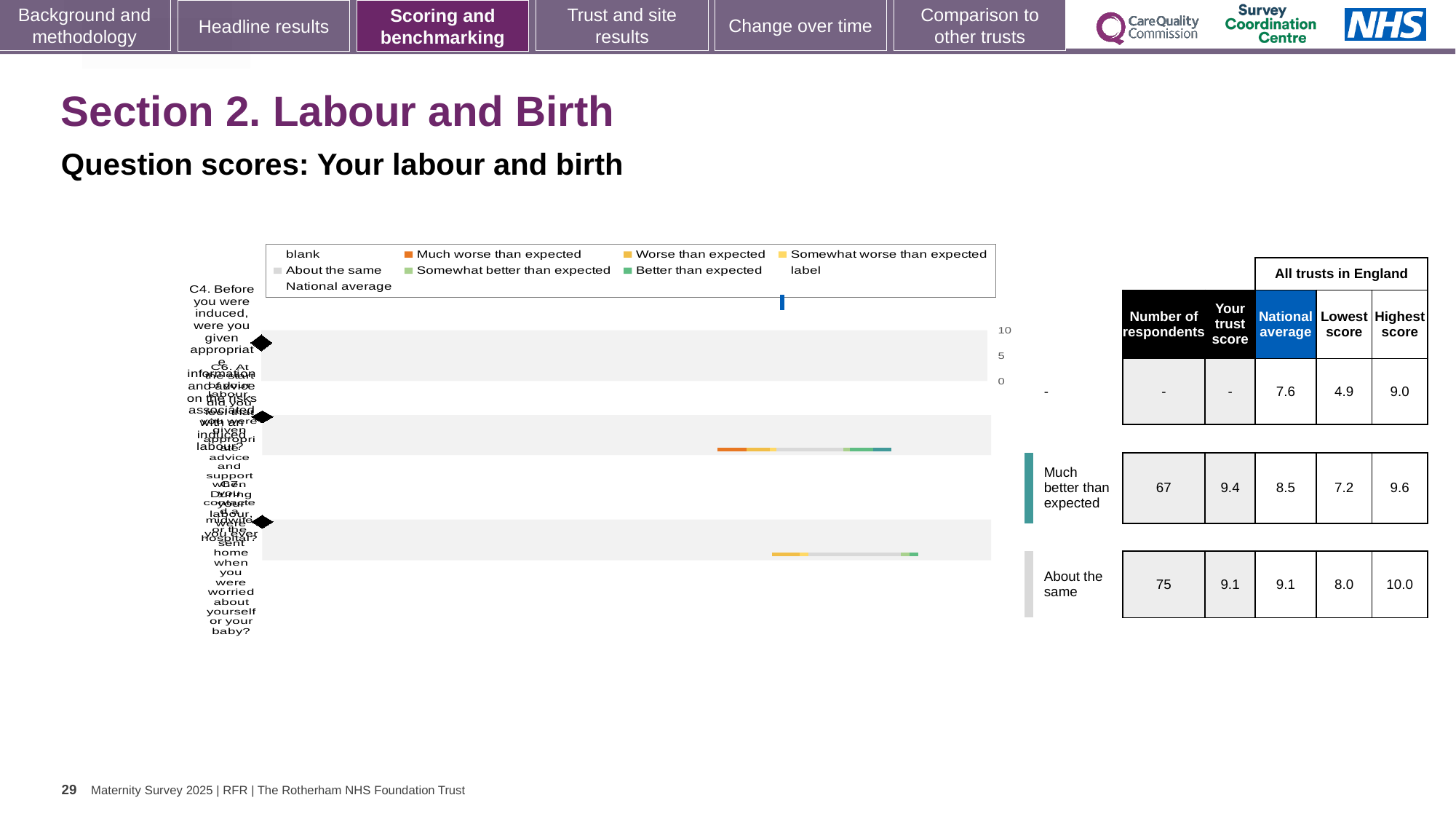
In the table beside the chart, what is the lowest score in the first row (the row with no trust score)? 4.9 For the 'Much better than expected' row, which is larger: the trust score or the national average? the trust score What kind of chart is shown on the slide? bar chart Which row in the table beside the chart has the highest number of respondents? About the same In the table beside the chart, how many respondents are listed for the row labelled 'About the same'? 75 For the 'About the same' row, what is the difference between the highest score (10.0) and the lowest score (8.0)? 2.0 In the table beside the chart, what is the 'Your trust score' for the row labelled 'Much better than expected'? 9.4 In the table beside the chart, what is the highest score for the row labelled 'About the same'? 10.0 Which colour does the chart legend use for 'Much worse than expected'? orange What is the highest value shown on the chart's numeric axis? 10 In the table beside the chart, what is the national average for the row labelled 'Much better than expected'? 8.5 For the 'Much better than expected' row, what is the difference between the trust score (9.4) and the national average (8.5)? 0.9